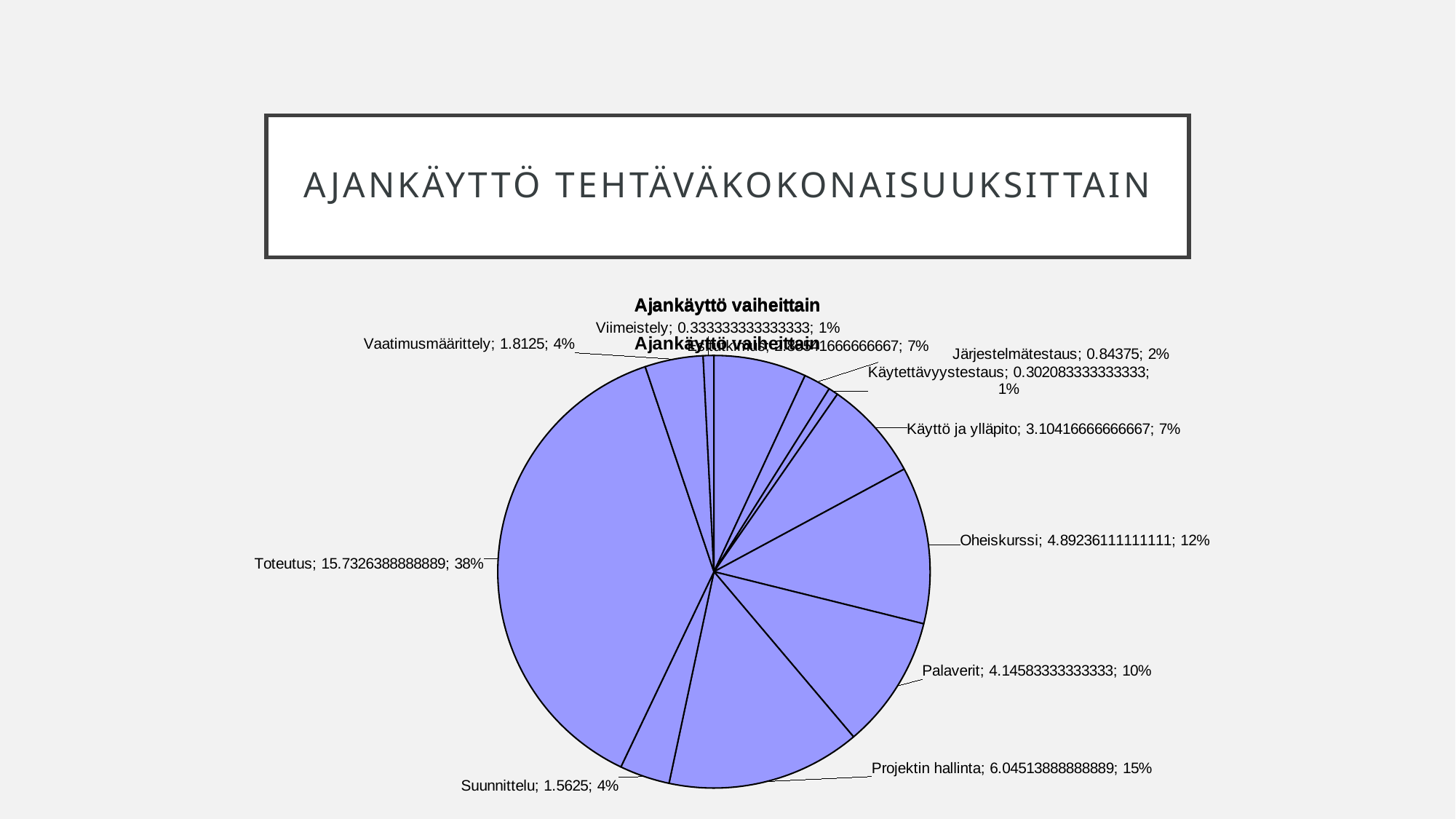
What type of chart is shown on the slide? Pie chart How many slices does the pie chart have? 11 What percentage is shown for Oheiskurssi? 12% What is the title of the chart? Ajankäyttö vaiheittain What is the difference in percentage points between Projektin hallinta (15%) and Oheiskurssi (12%)? 3 percentage points What percentage is shown for Suunnittelu? 4% What is the value shown for Käyttö ja ylläpito? 3.10416666666667 What is the value shown for Projektin hallinta? 6.04513888888889 Which category has the largest slice of the pie? Toteutus What share of the pie does Toteutus take? 38% Which is larger, the slice for Palaverit or the slice for Oheiskurssi? Oheiskurssi Which category has the smallest value in the pie? Käytettävyystestaus